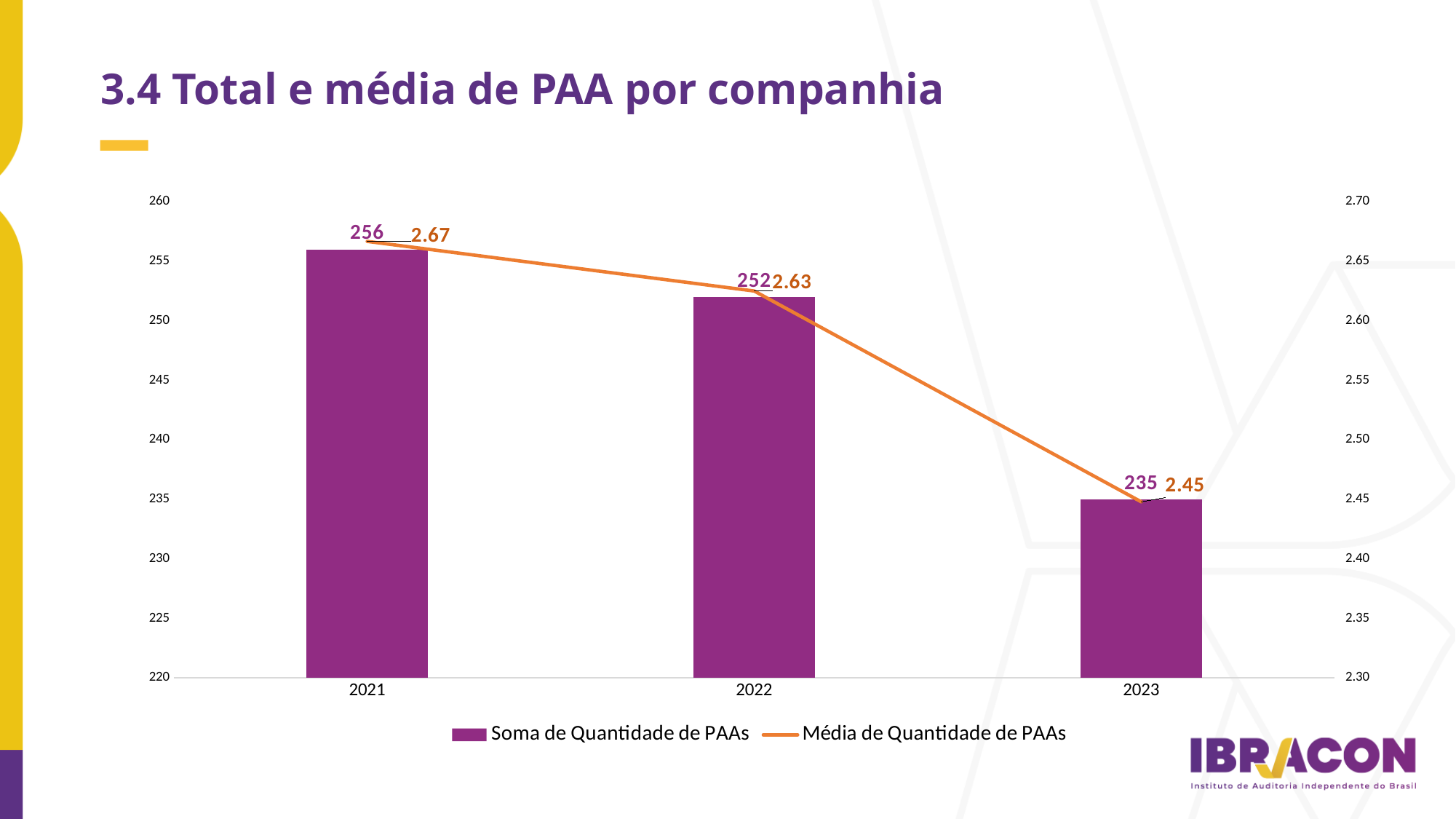
What is the value of Soma de Quantidade de PAAs for 2021? 256 Which year has the highest Média de Quantidade de PAAs? 2021 What is the value of Média de Quantidade de PAAs for 2022? 2.63 Does the Média de Quantidade de PAAs rise or fall from 2021 to 2023? fall How many years are shown on the x axis? 3 What colour is the line for Média de Quantidade de PAAs? orange What is the difference between the Soma de Quantidade de PAAs for 2021 and 2023? 21 What is the value of Média de Quantidade de PAAs for 2023? 2.45 What is the value of Soma de Quantidade de PAAs for 2022? 252 How many series does the legend list? 2 Which year has the lowest Soma de Quantidade de PAAs? 2023 Is the Soma de Quantidade de PAAs larger for 2021 or 2022? 2021